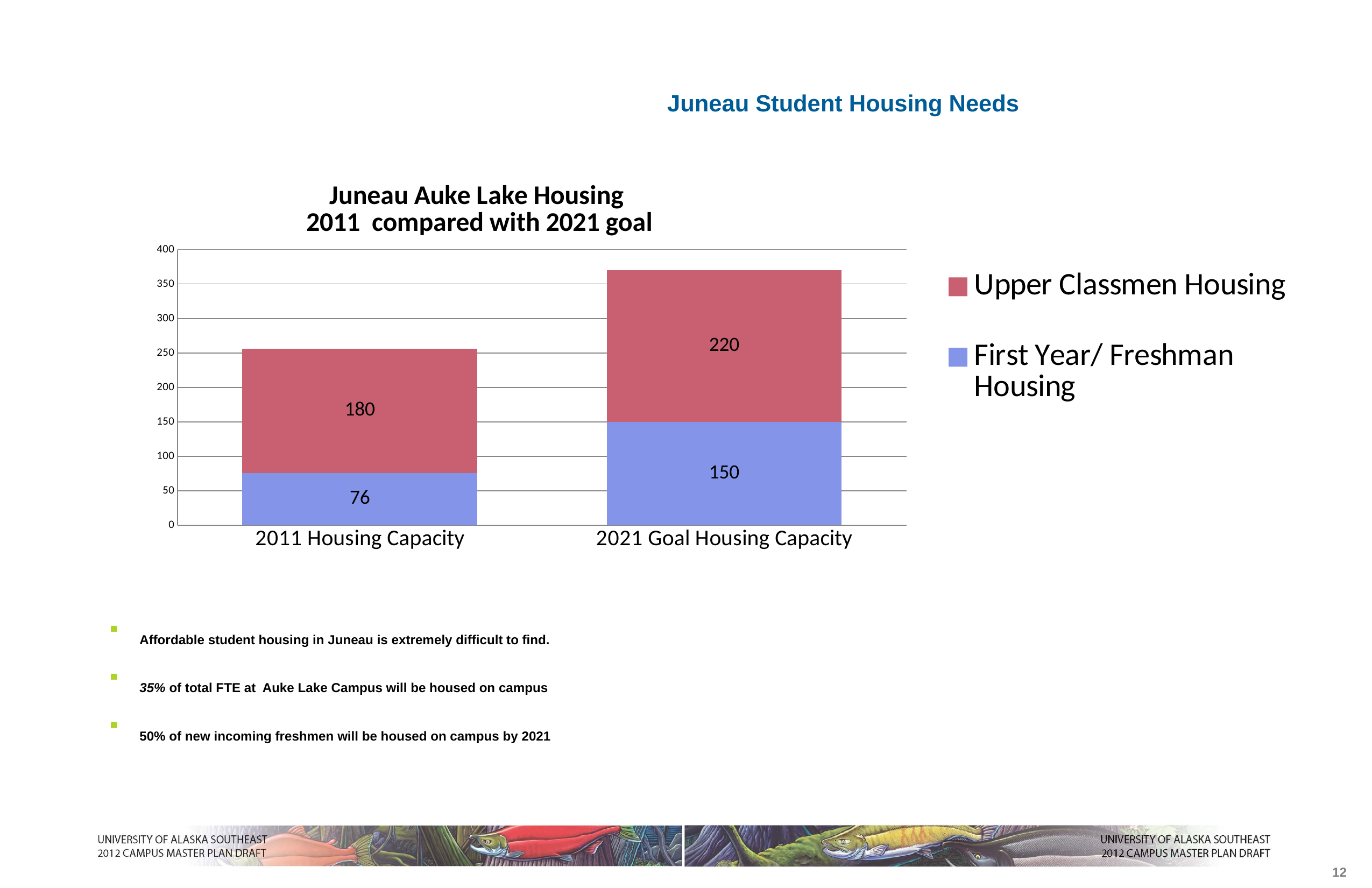
How many categories are shown on the x axis? 2 What is the total of the 2021 Goal Housing Capacity stacked bar? 370 What is the value for First Year/ Freshman Housing in the 2021 Goal Housing Capacity bar? 150 What is the value for Upper Classmen Housing in the 2021 Goal Housing Capacity bar? 220 What is the value for Upper Classmen Housing in the 2011 Housing Capacity bar? 180 What is the value for First Year/ Freshman Housing in the 2011 Housing Capacity bar? 76 How many series does the legend list? 2 What is the title of the chart? Juneau Auke Lake Housing 2011 compared with 2021 goal What kind of chart is shown on the slide? Stacked bar chart What is the total of the 2011 Housing Capacity stacked bar? 256 Which category has the higher Upper Classmen Housing value, 2011 Housing Capacity or 2021 Goal Housing Capacity? 2021 Goal Housing Capacity How much higher is First Year/ Freshman Housing in 2021 Goal Housing Capacity than in 2011 Housing Capacity? 74